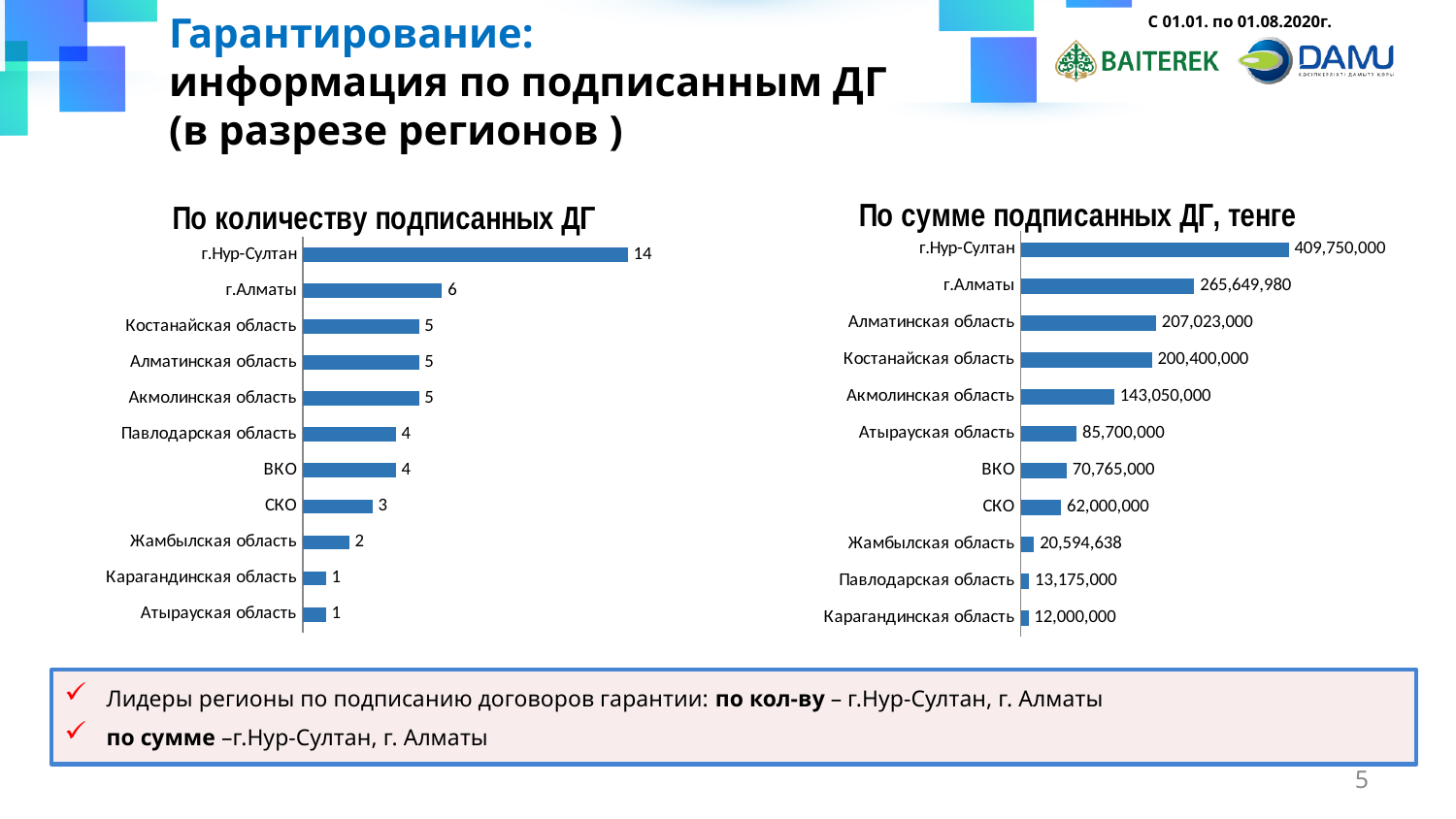
In the chart 'По сумме подписанных ДГ, тенге', which region has the lowest value? Карагандинская область In the chart 'По количеству подписанных ДГ', which region has the lowest value? Карагандинская область and Атырауская область (both 1) In the chart 'По сумме подписанных ДГ, тенге', which region has the highest value? г.Нур-Султан In the chart 'По количеству подписанных ДГ', how many regions are shown? 11 In the chart 'По сумме подписанных ДГ, тенге', what is the value for Акмолинская область? 143,050,000 In the chart 'По сумме подписанных ДГ, тенге', which is larger: Алматинская область or Костанайская область? Алматинская область In the chart 'По количеству подписанных ДГ', what is the difference between г.Нур-Султан and г.Алматы? 8 What is the title of the chart on the right side of the slide? По сумме подписанных ДГ, тенге In the chart 'По количеству подписанных ДГ', what is the value for г.Нур-Султан? 14 In the chart 'По сумме подписанных ДГ, тенге', what is the difference between г.Нур-Султан and г.Алматы? 144,100,020 What type of chart is 'По количеству подписанных ДГ'? Bar chart In the chart 'По сумме подписанных ДГ, тенге', what is the value for Жамбылская область? 20,594,638